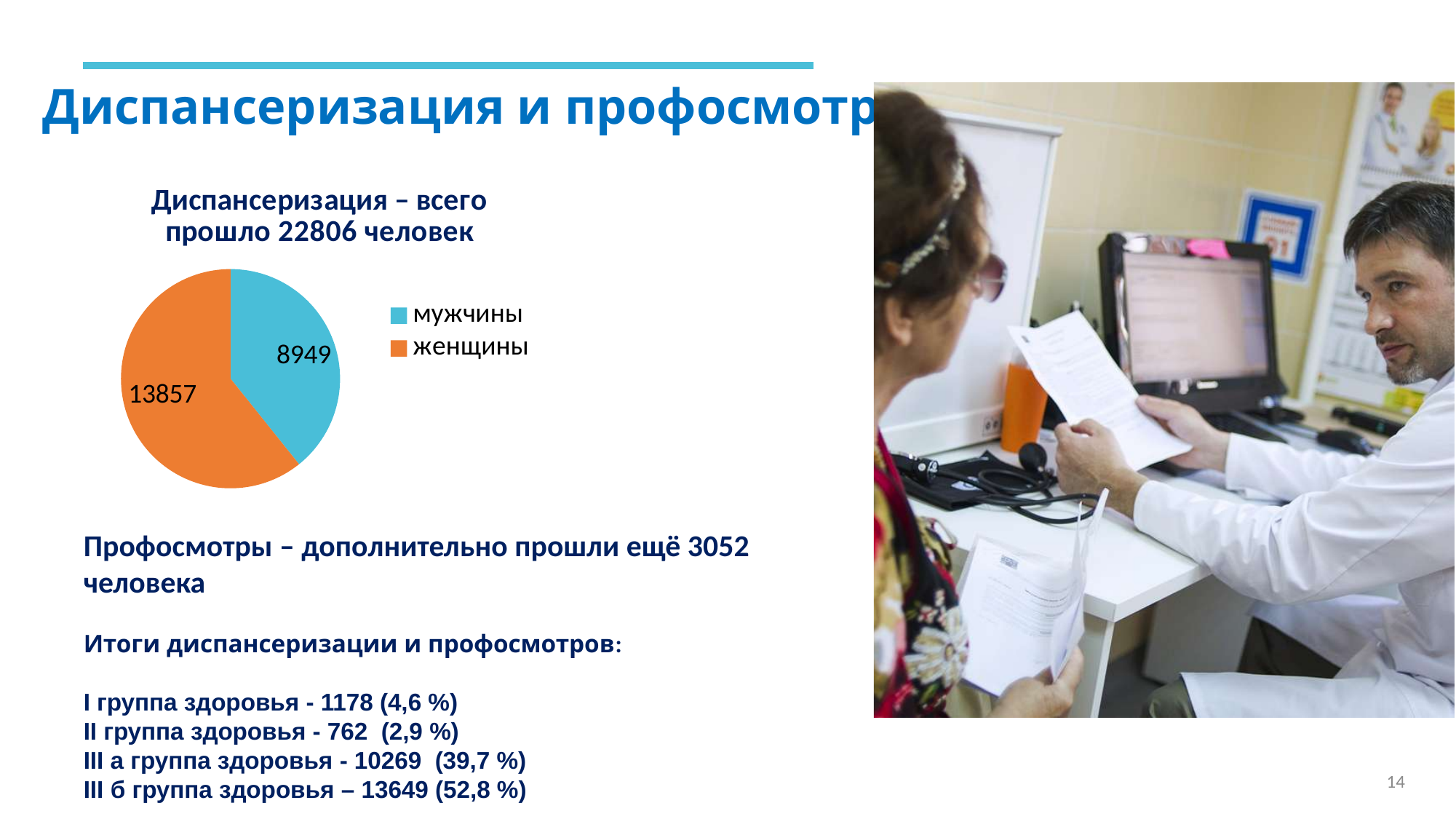
What is the difference between the values for женщины and мужчины in the pie chart? 4908 What is the total number of people represented by the pie chart, as stated in its title? 22806 How many entries does the legend of the pie chart list? 2 What is the title of the pie chart? Диспансеризация – всего прошло 22806 человек What colour is the женщины slice in the pie chart? orange What kind of chart is shown on the slide? pie chart Which is larger in the pie chart, the value for мужчины or the value for женщины? женщины How many slices does the pie chart have? 2 Which category has the smallest slice in the pie chart? мужчины Which category has the largest slice in the pie chart? женщины What value is shown for мужчины in the pie chart? 8949 What value is shown for женщины in the pie chart? 13857